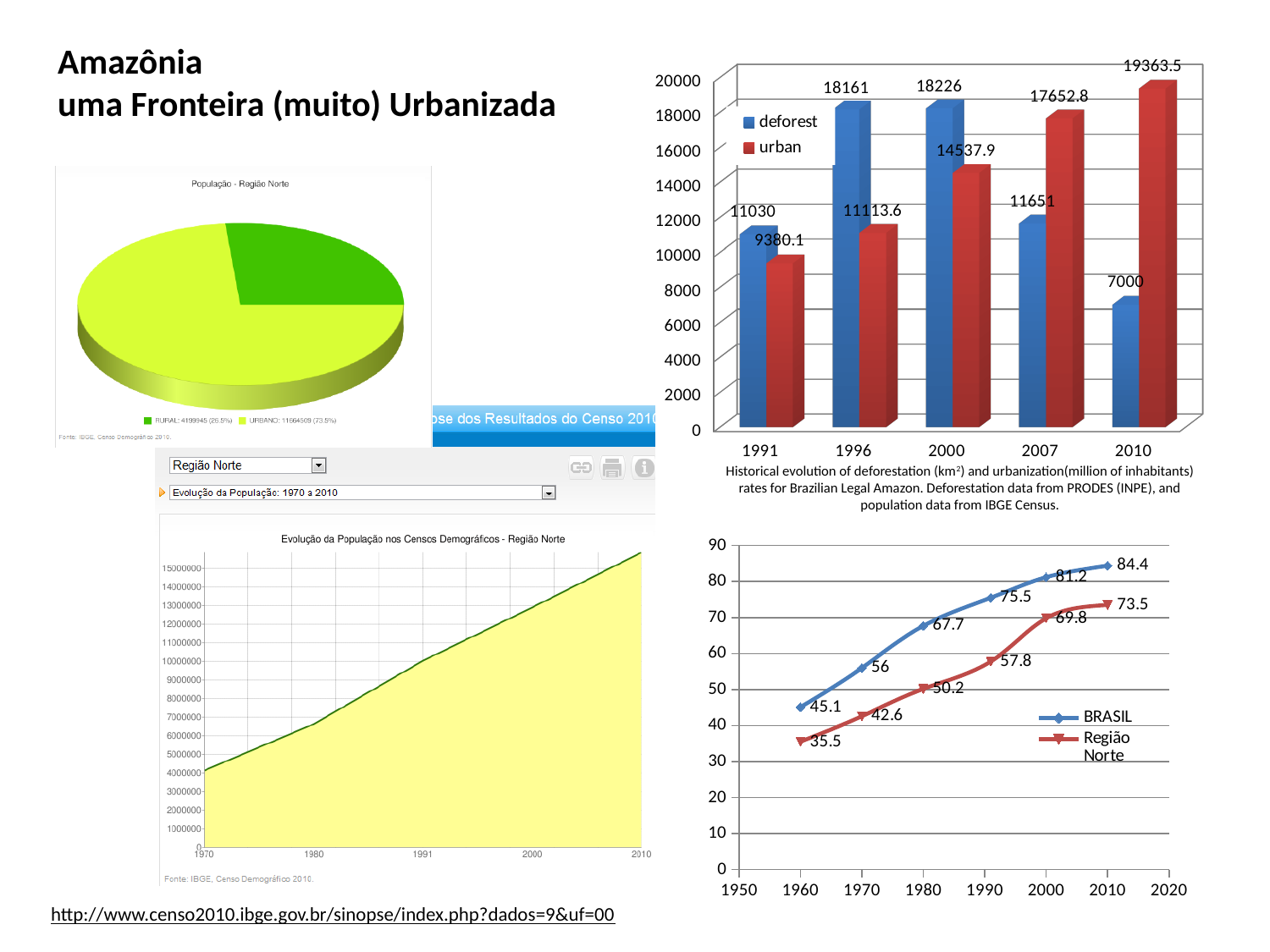
What kind of chart is the bottom-right chart showing BRASIL and Região Norte? line chart In the bottom-right line chart, do the Região Norte values rise or fall from 1960 to 2010? rise In the top-right bar chart, what is the urban value for 2010? 19363.5 In the top-right bar chart, what is the deforest value for 1996? 18161 In the top-right bar chart, what is the difference between the deforest values for 2000 and 2010? 11226 In the bottom-right line chart, what is the difference between the BRASIL and Região Norte values for 1960? 9.6 In the bottom-right line chart, what is the Região Norte value for 2000? 69.8 In the bottom-right line chart, what is the BRASIL value for 1980? 67.7 In the top-right bar chart, which year has the lowest urban value? 1991 In the top-right bar chart, which year has the highest deforest value? 2000 How many series does the legend of the top-right bar chart list? 2 In the top-right bar chart, which is larger for 2007: the deforest value or the urban value? urban